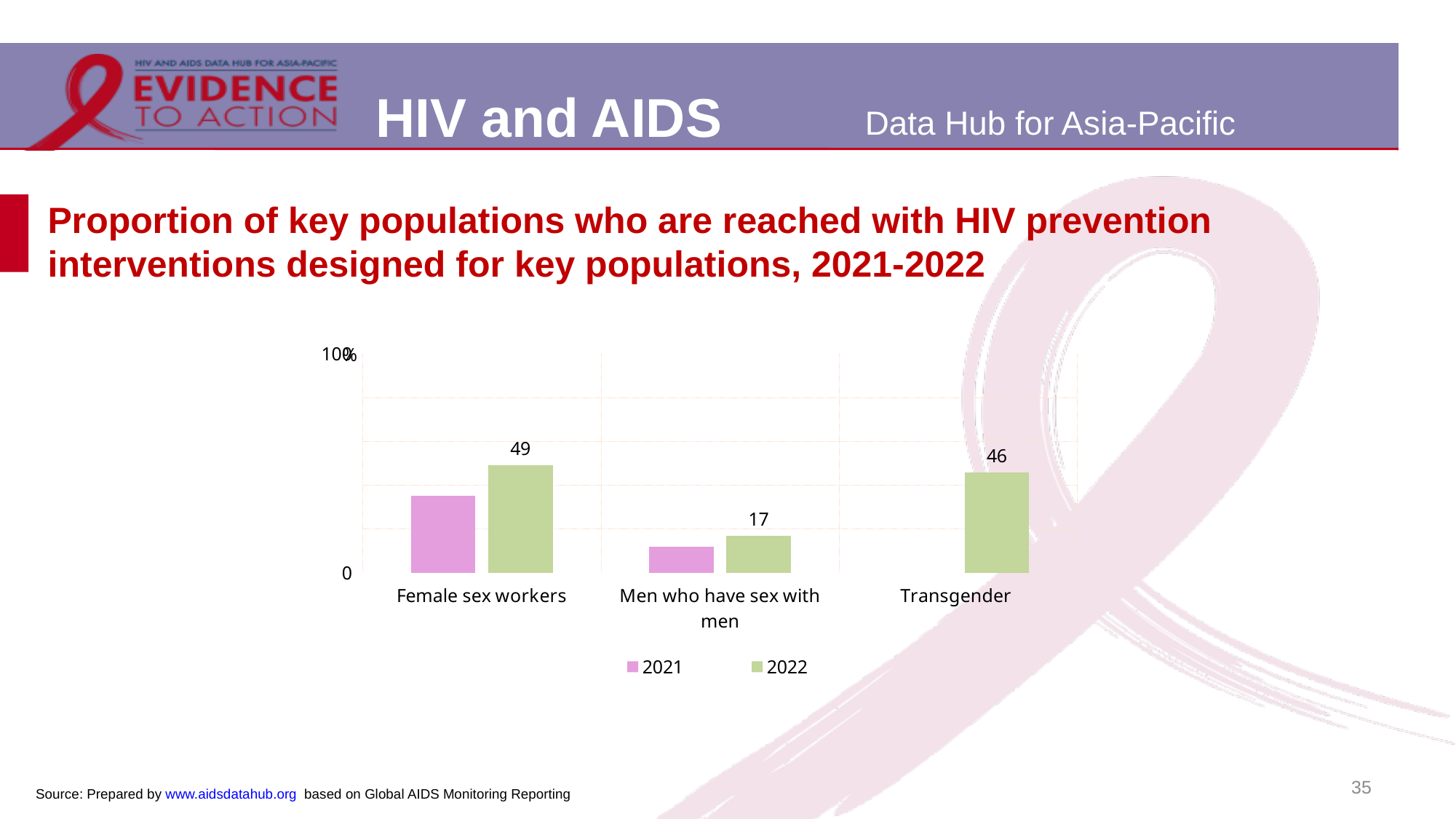
What is the difference between the 2022 values for Female sex workers and Transgender? 3 How many key population categories are shown on the x axis? 3 What is the value for Transgender in 2022? 46 What is the value for Female sex workers in 2022? 49 Which key population has the highest value in 2022? Female sex workers What is the difference between the 2022 values for Female sex workers and Men who have sex with men? 32 Which key population has the lowest value in 2022? Men who have sex with men For Female sex workers, which year has the larger value, 2021 or 2022? 2022 What is the value for Men who have sex with men in 2022? 17 How many series does the legend list? 2 For Men who have sex with men, which year has the larger value, 2021 or 2022? 2022 What kind of chart is shown on the slide? Bar chart